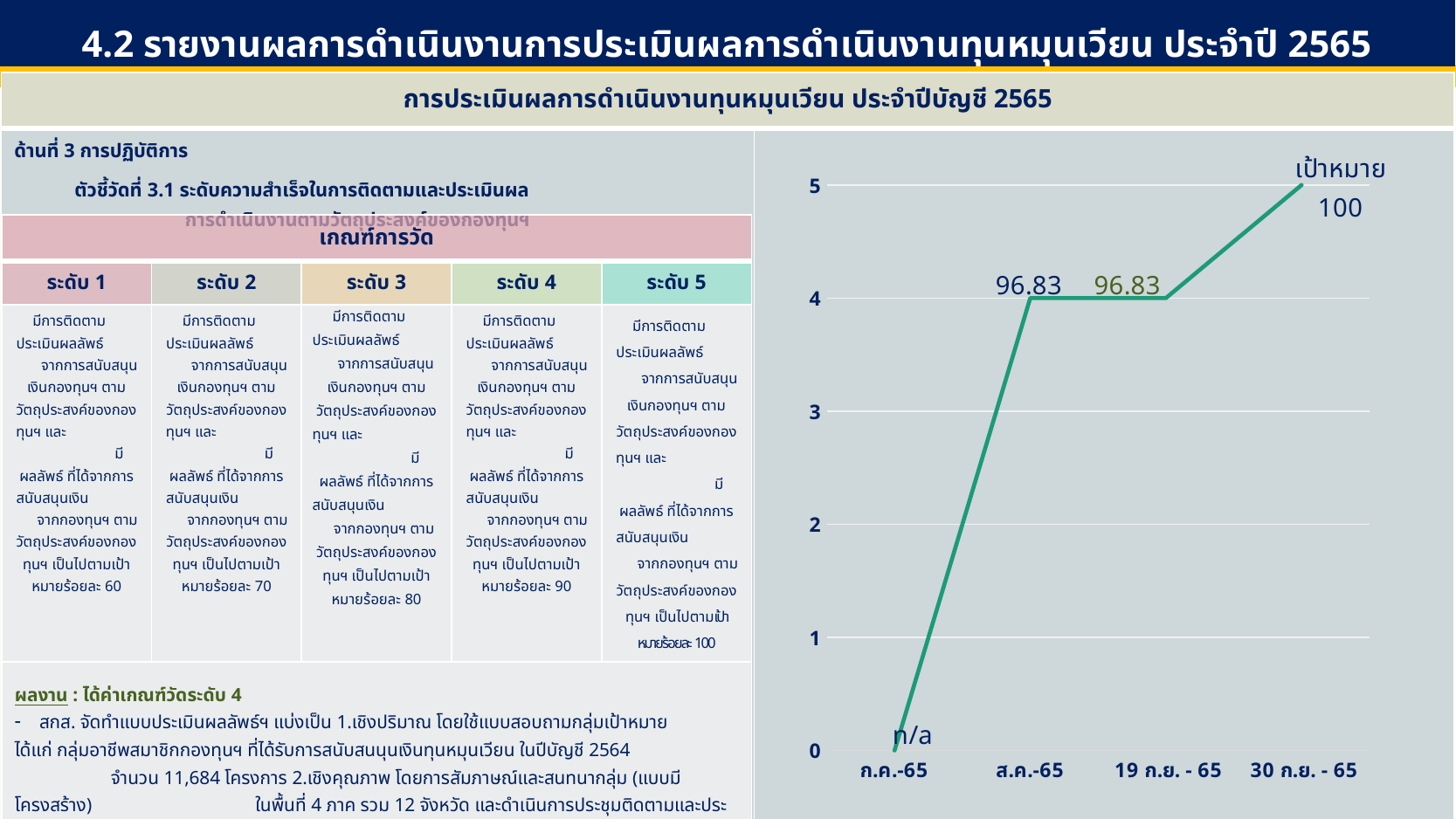
Do the values on the line chart rise or fall from ก.ค.-65 to 30 ก.ย. - 65? rise What kind of chart is shown on the right side of the slide? line chart How many points (categories) are plotted along the x axis of the line chart? 4 Which x-axis category has the highest point on the line chart? 30 ก.ย. - 65 What data label is shown for ก.ค.-65 on the line chart? n/a What word is written above the data label 100 at the top right of the line chart? เป้าหมาย On the line chart, is the point for ส.ค.-65 greater or less than 3 on the y axis? greater Which x-axis category has the lowest point on the line chart? ก.ค.-65 What data label is shown for 30 ก.ย. - 65 on the line chart? 100 What data label is shown for 19 ก.ย. - 65 on the line chart? 96.83 What data label is shown for ส.ค.-65 on the line chart? 96.83 On the line chart, is the point for ก.ค.-65 greater or less than 1 on the y axis? less